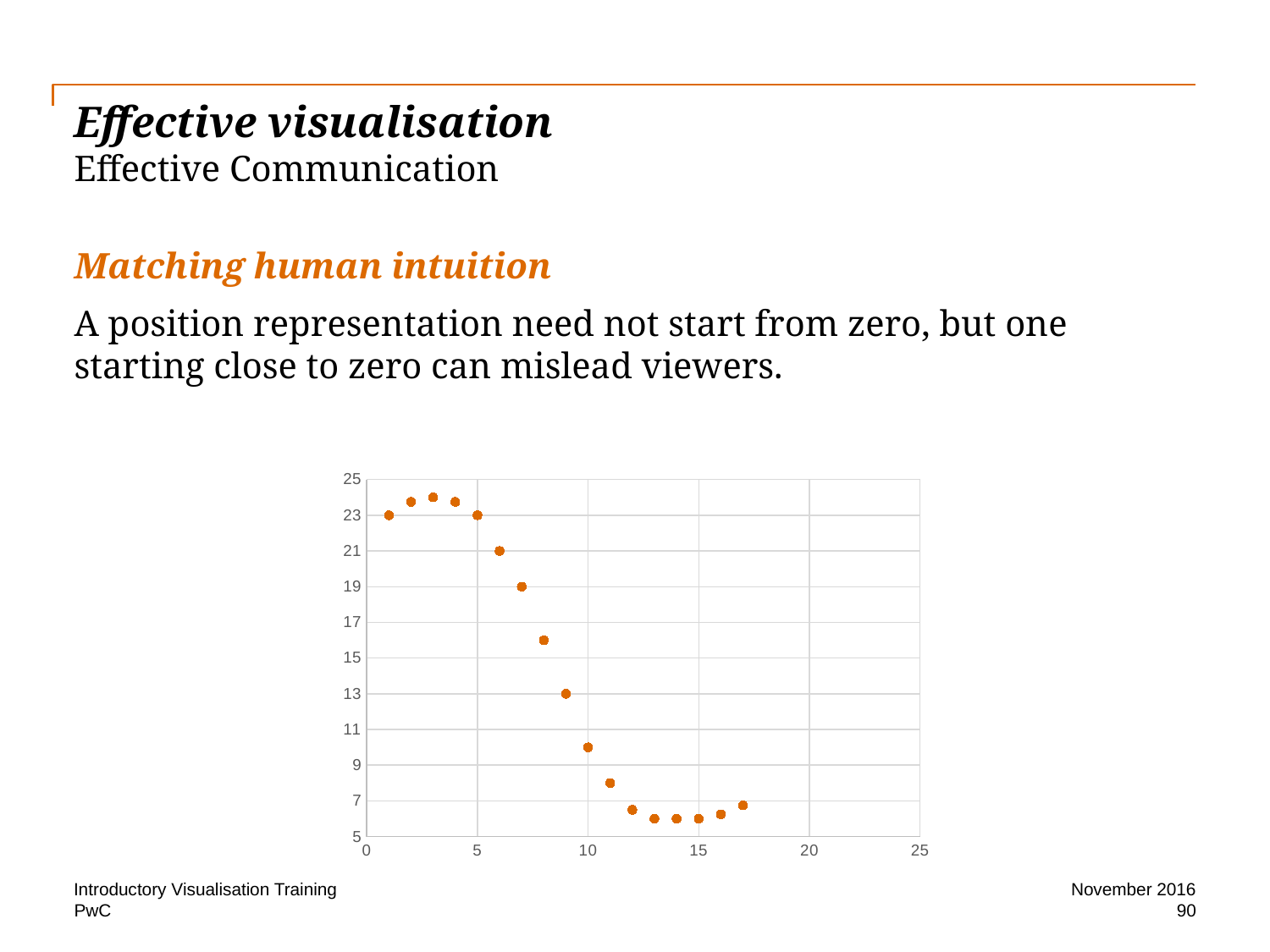
What is the y value of the point at x = 7? 19 What is the y value of the point at x = 9? 13 How many data points are plotted on the chart? 17 Is the y value of the point at x = 3 greater or less than 23? greater Which point has the larger y value, the one at x = 1 or the one at x = 17? x = 1 Do the plotted values generally rise or fall as x increases from 1 to 17? fall Is the y value of the point at x = 8 greater or less than 15? greater What is the y value of the point at x = 6? 21 Is the y value of the point at x = 13 greater or less than 7? less At what value does the y axis of the chart start? 5 What is the y value of the point at x = 1? 23 What kind of chart is shown on the slide? scatter chart